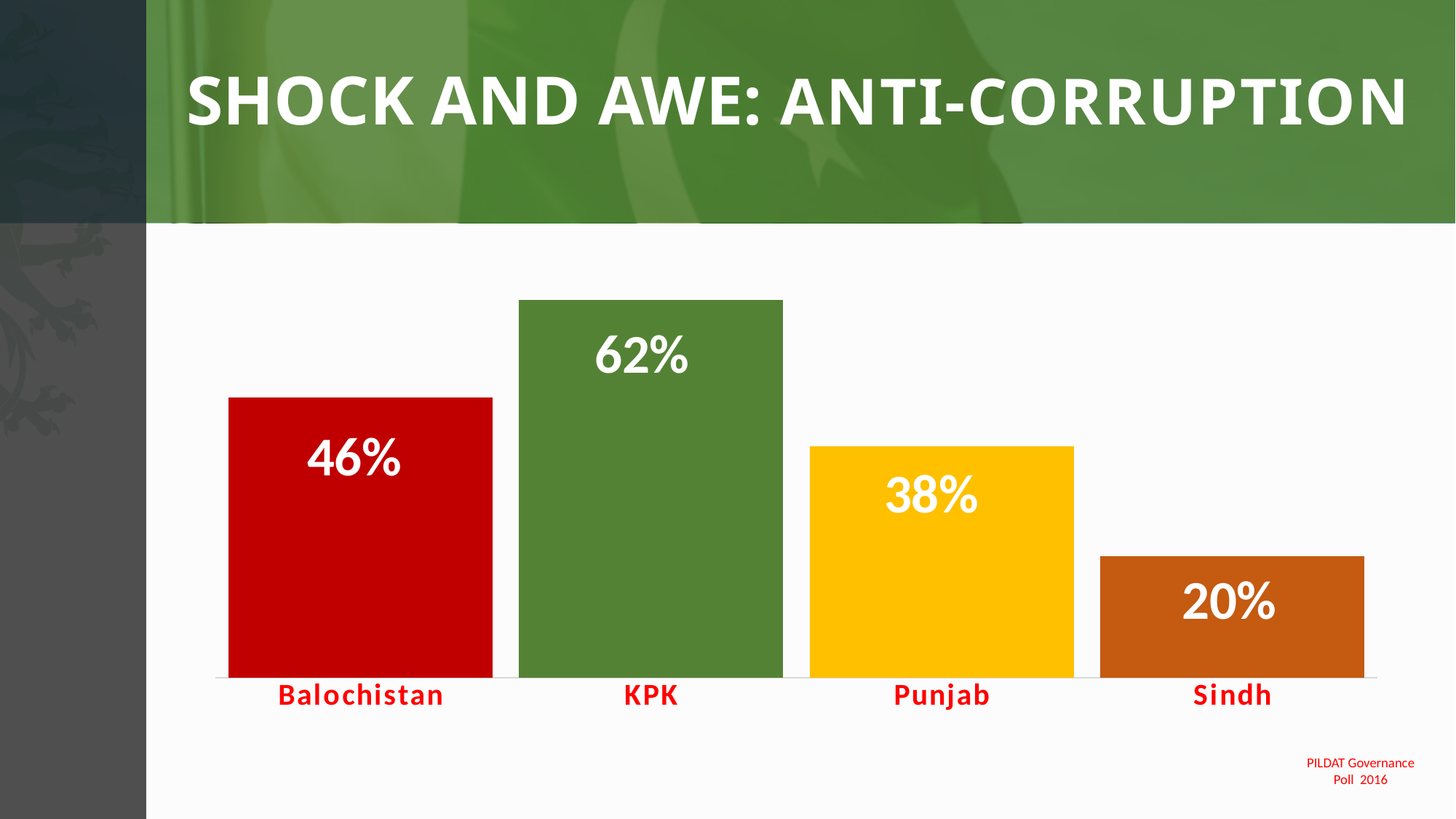
What is the difference between the values for Balochistan and Punjab? 8% What is the value for KPK? 62% Which province has the lowest value? Sindh What is the value for Punjab? 38% What kind of chart is shown on the slide? Bar chart How many provinces are shown in the chart? 4 Which province has the highest value? KPK What is the value for Balochistan? 46% What is the value for Sindh? 20% What is the difference between the values for KPK and Sindh? 42% Which is larger, the value for Balochistan or the value for Punjab? Balochistan What colour is the bar for Punjab? Yellow